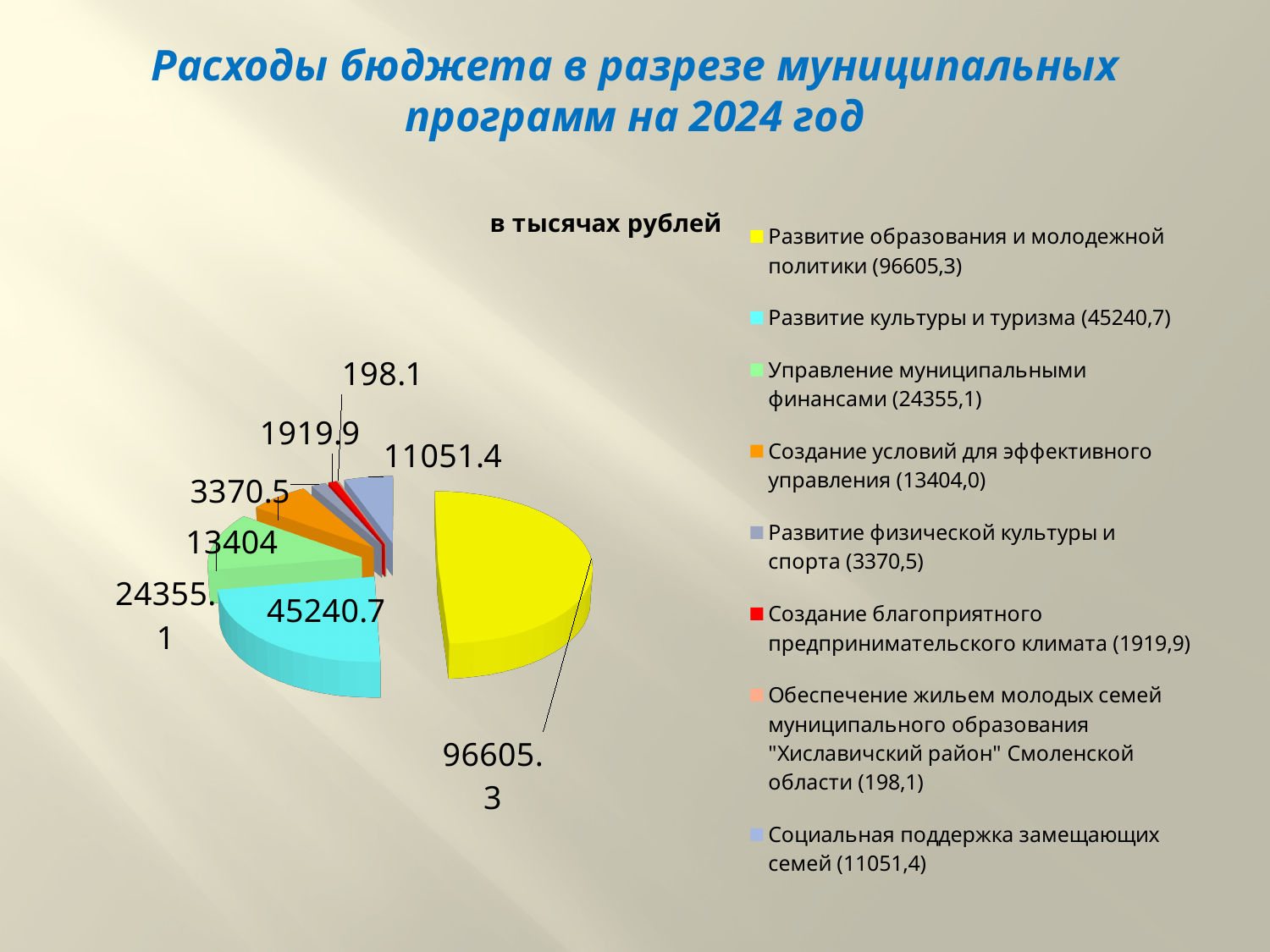
What is the value for Развитие культуры и туризма? 45240.7 Which program has the smallest slice of the pie? Обеспечение жильем молодых семей муниципального образования "Хиславичский район" Смоленской области What is the value for Социальная поддержка замещающих семей? 11051.4 Which is larger: the value for Создание условий для эффективного управления or the value for Социальная поддержка замещающих семей? Создание условий для эффективного управления How many entries does the legend list? 8 What is the value for Управление муниципальными финансами? 24355.1 Which program has the largest slice of the pie? Развитие образования и молодежной политики What is the value for Развитие образования и молодежной политики? 96605.3 How many slices does the pie chart have? 8 What type of chart is shown on the slide? pie chart In what units are the values on the chart given, according to the label above the chart? в тысячах рублей What is the difference between the values for Развитие образования и молодежной политики and Развитие культуры и туризма? 51364.6